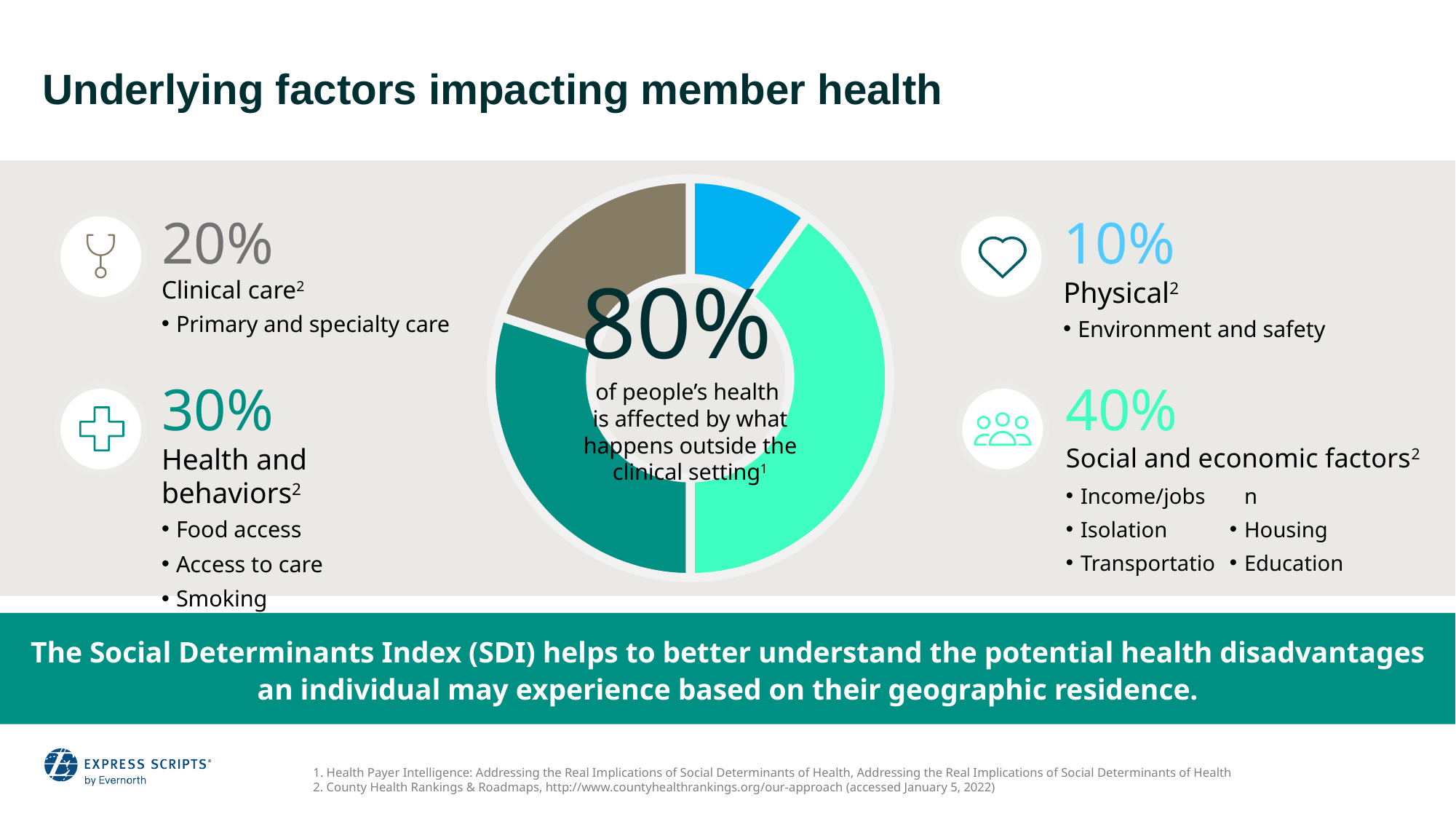
What is the difference in percentage points between Social and economic factors and Clinical care? 20 What percentage is printed in the center of the donut chart? 80% What colour is the segment representing Physical factors? Blue What percentage is shown for Clinical care? 20% How many segments does the donut chart have? 4 Which is larger, the share for Health and behaviors or the share for Physical? Health and behaviors What percentage is shown for Health and behaviors? 30% What percentage is shown for Social and economic factors? 40% Which factor has the largest share of the donut chart? Social and economic factors Which factor has the smallest share of the donut chart? Physical What kind of chart is shown on the slide? Donut (pie) chart What percentage is shown for Physical? 10%